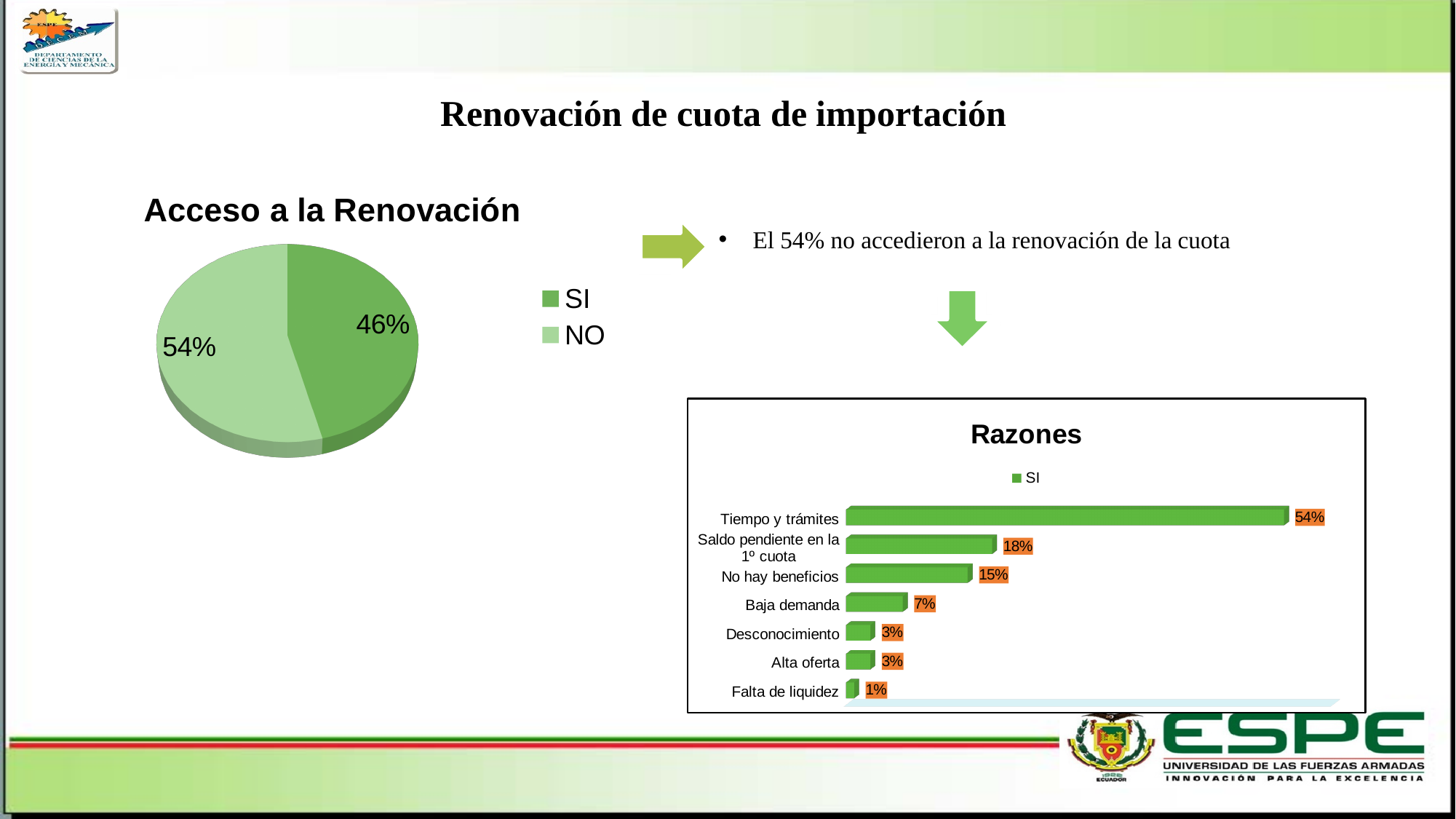
In the 'Acceso a la Renovación' pie chart, what share is labelled for SI? 46% In the 'Razones' chart, which category has the highest value? Tiempo y trámites What kind of chart is 'Acceso a la Renovación'? Pie chart In the 'Razones' chart, what is the value for Tiempo y trámites? 54% In the 'Razones' chart, which category has the lowest value? Falta de liquidez In the 'Razones' chart, what is the value for No hay beneficios? 15% In the 'Acceso a la Renovación' pie chart, what share is labelled for NO? 54% What kind of chart is 'Razones'? Bar chart How many categories are shown in the 'Razones' chart? 7 In the 'Acceso a la Renovación' chart, which slice is larger, SI or NO? NO In the 'Razones' chart, what is the difference between Saldo pendiente en la 1º cuota and Baja demanda? 11% How many entries does the legend of the 'Acceso a la Renovación' chart list? 2